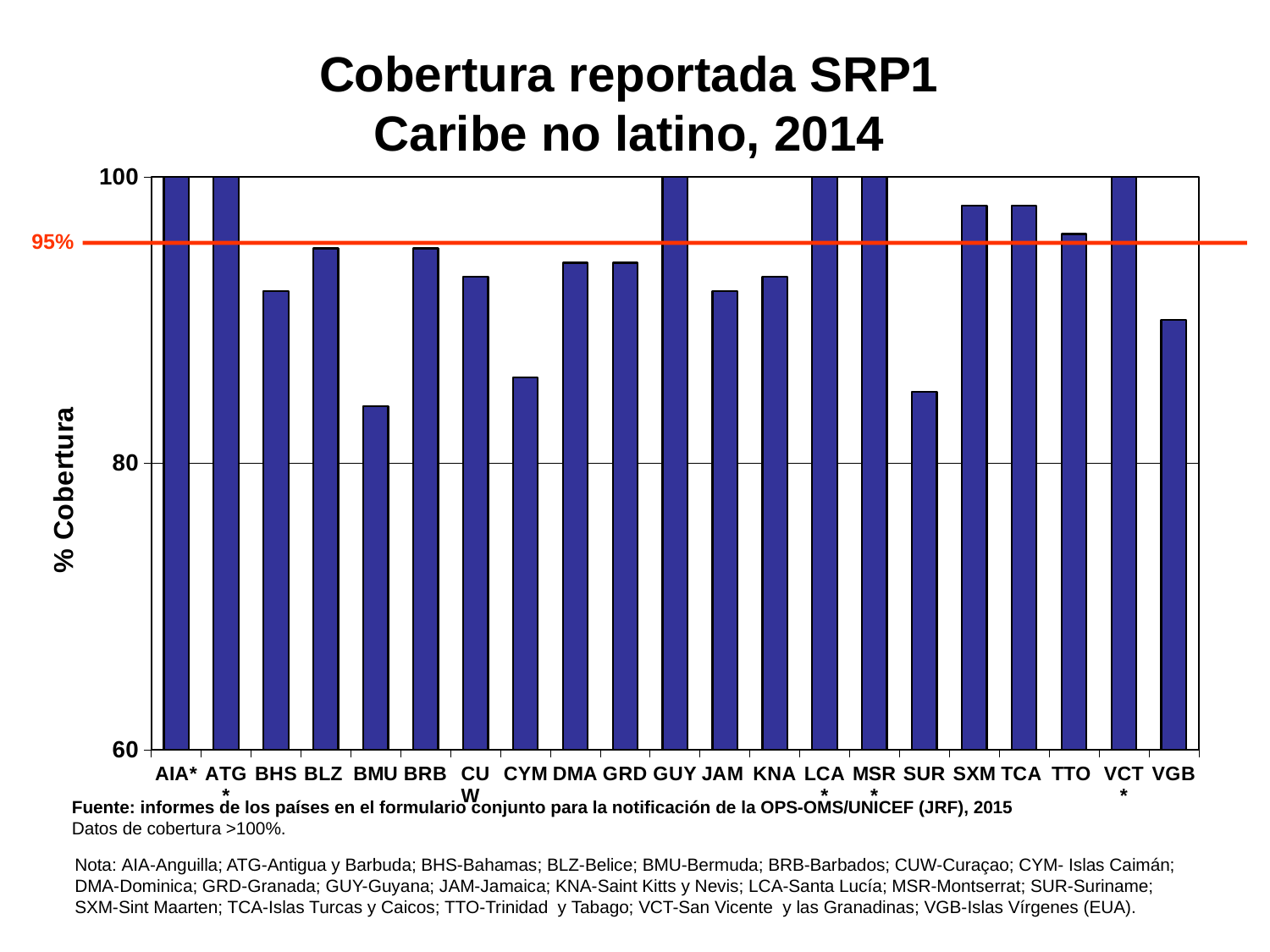
Is the value for BMU greater or less than 95? less What kind of chart is shown on the slide? bar chart Is the value for VGB greater or less than 95? less Is the value for CYM greater or less than 95? less Which has the higher value, VGB or BMU? VGB How many countries/territories are shown on the x axis of the chart? 21 What value does the red horizontal line on the chart mark? 95% What is the title of the chart? Cobertura reportada SRP1 Caribe no latino, 2014 Which has the higher value, SXM or BHS? SXM